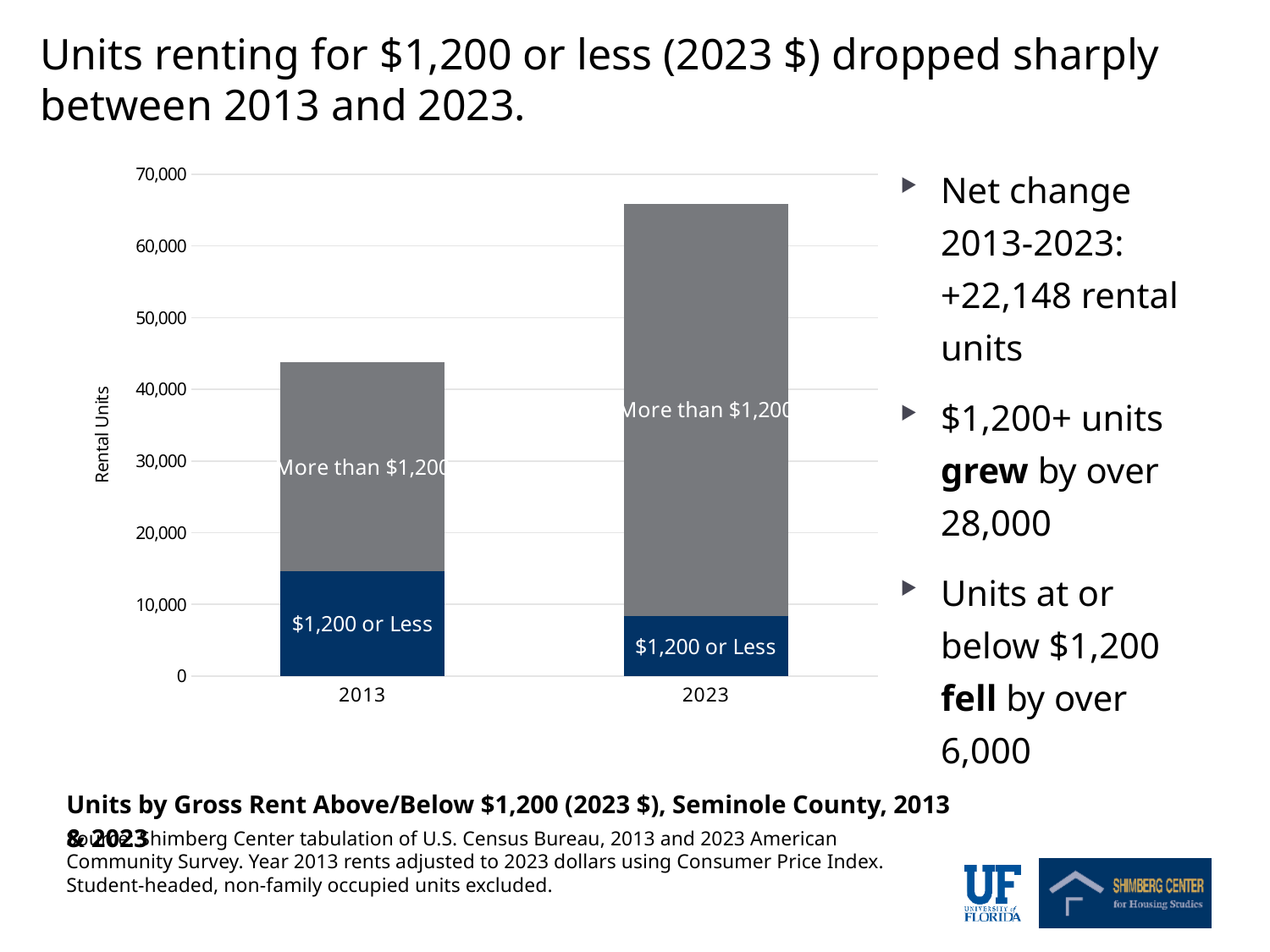
How many rent segments are stacked in each bar of the chart? 2 Does the total number of rental units rise or fall from 2013 to 2023? rise Is the total number of rental units in 2023 greater or less than 60,000? greater What type of chart is shown on the slide? Stacked bar chart Is the number of units renting for $1,200 or less in 2013 greater or less than 10,000? greater How many years (categories) are shown on the x axis of the chart? 2 Which year has more units renting for $1,200 or less, 2013 or 2023? 2013 What is the label on the vertical axis of the chart? Rental Units Is the total number of rental units in 2013 greater or less than 40,000? greater Which year has the taller total bar, 2013 or 2023? 2023 Which county does the chart's caption say the data is for? Seminole County